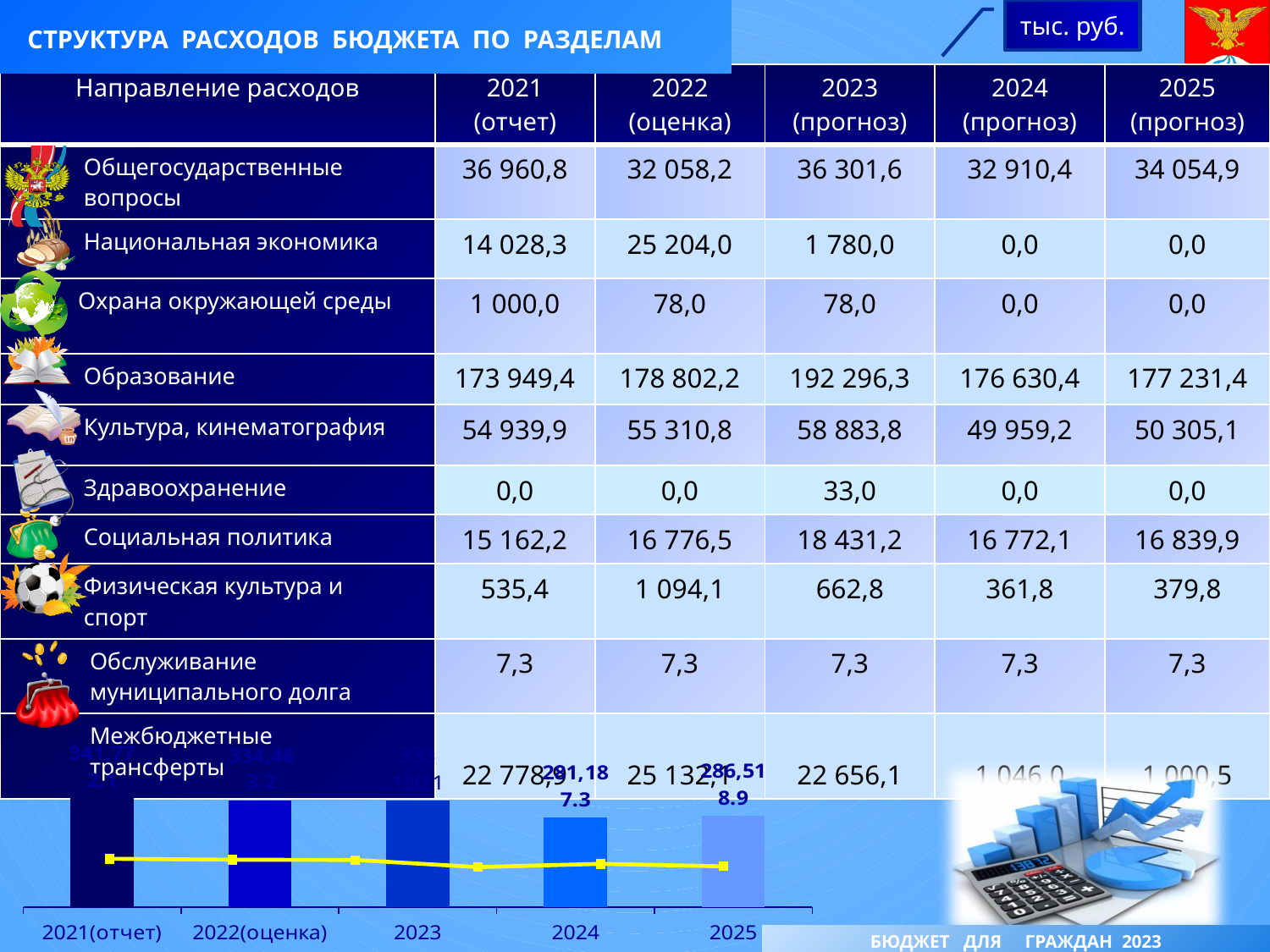
What kind of chart is shown at the bottom of the slide? bar chart with a line How many categories are shown on the x axis of the chart at the bottom of the slide? 5 What is the first category label on the x axis of the chart at the bottom of the slide? 2021(отчет) In the chart at the bottom of the slide, which bar has the larger data label, 2024 or 2025? 2025 In the chart at the bottom of the slide, what data label is printed above the bar for 2025? 286,518.9 In the chart at the bottom of the slide, what data label is printed above the bar for 2024? 281,187.3 What is the last category label on the x axis of the chart at the bottom of the slide? 2025